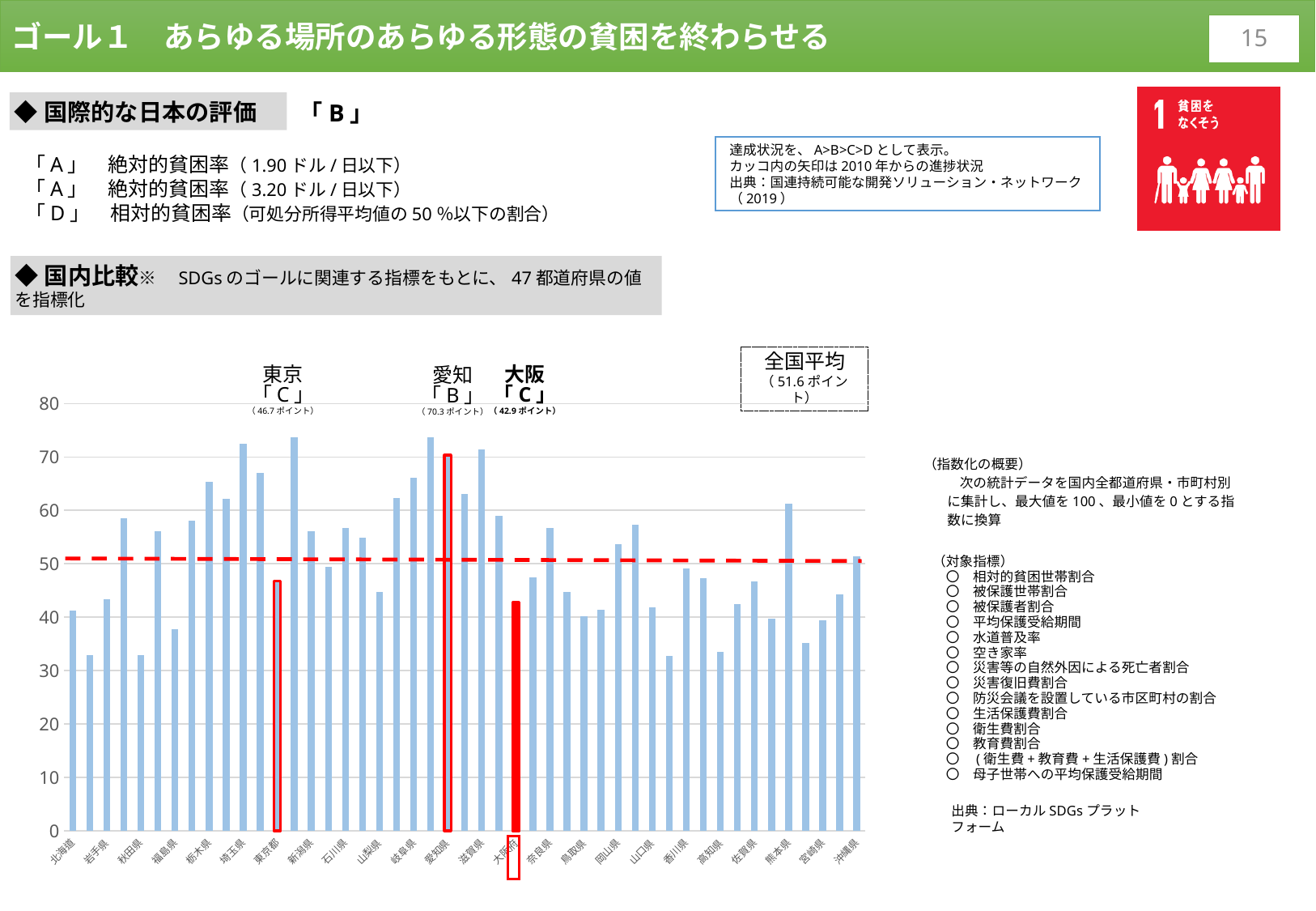
What is the value shown for 東京 on the bar chart? 46.7 ポイント How many prefectures are plotted on the bar chart? 47 What kind of chart is used to show the prefecture values? bar chart What is the value shown for 大阪 on the bar chart? 42.9 ポイント What is the difference between the values for 東京 and 大阪? 3.8 ポイント What is the value shown for 愛知 on the bar chart? 70.3 ポイント What is the 全国平均 (national average) value indicated on the chart? 51.6 ポイント Which is larger, the value for 東京 or the 全国平均? 全国平均 Is the value for 北海道 greater or less than 50? less What is the difference between the values for 愛知 and 東京? 23.6 ポイント Which has the larger value, 愛知 or 大阪? 愛知 Is the value for 埼玉県 greater or less than 70? greater